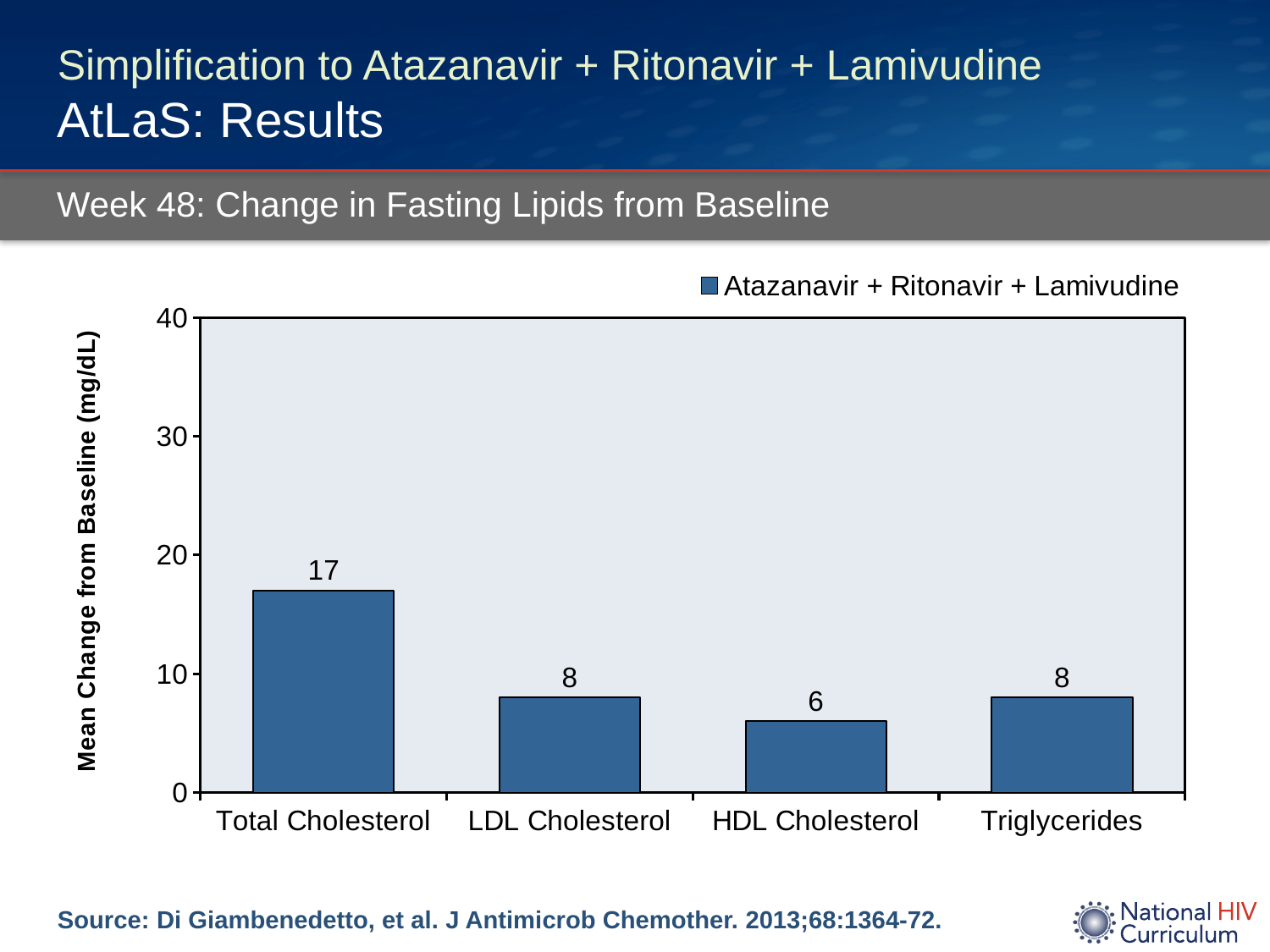
Which category has the highest mean change from baseline? Total Cholesterol What kind of chart is shown on the slide? Bar chart What is the mean change from baseline for HDL Cholesterol? 6 How many categories are shown on the x axis? 4 What is the mean change from baseline for Total Cholesterol? 17 Is the value for Total Cholesterol greater or less than 20? less What is the difference between the values for Total Cholesterol and HDL Cholesterol? 11 What is the mean change from baseline for LDL Cholesterol? 8 Which is larger, the value for Total Cholesterol or the value for Triglycerides? Total Cholesterol Which category has the lowest mean change from baseline? HDL Cholesterol What is the difference between the values for LDL Cholesterol and HDL Cholesterol? 2 What series does the legend list? Atazanavir + Ritonavir + Lamivudine